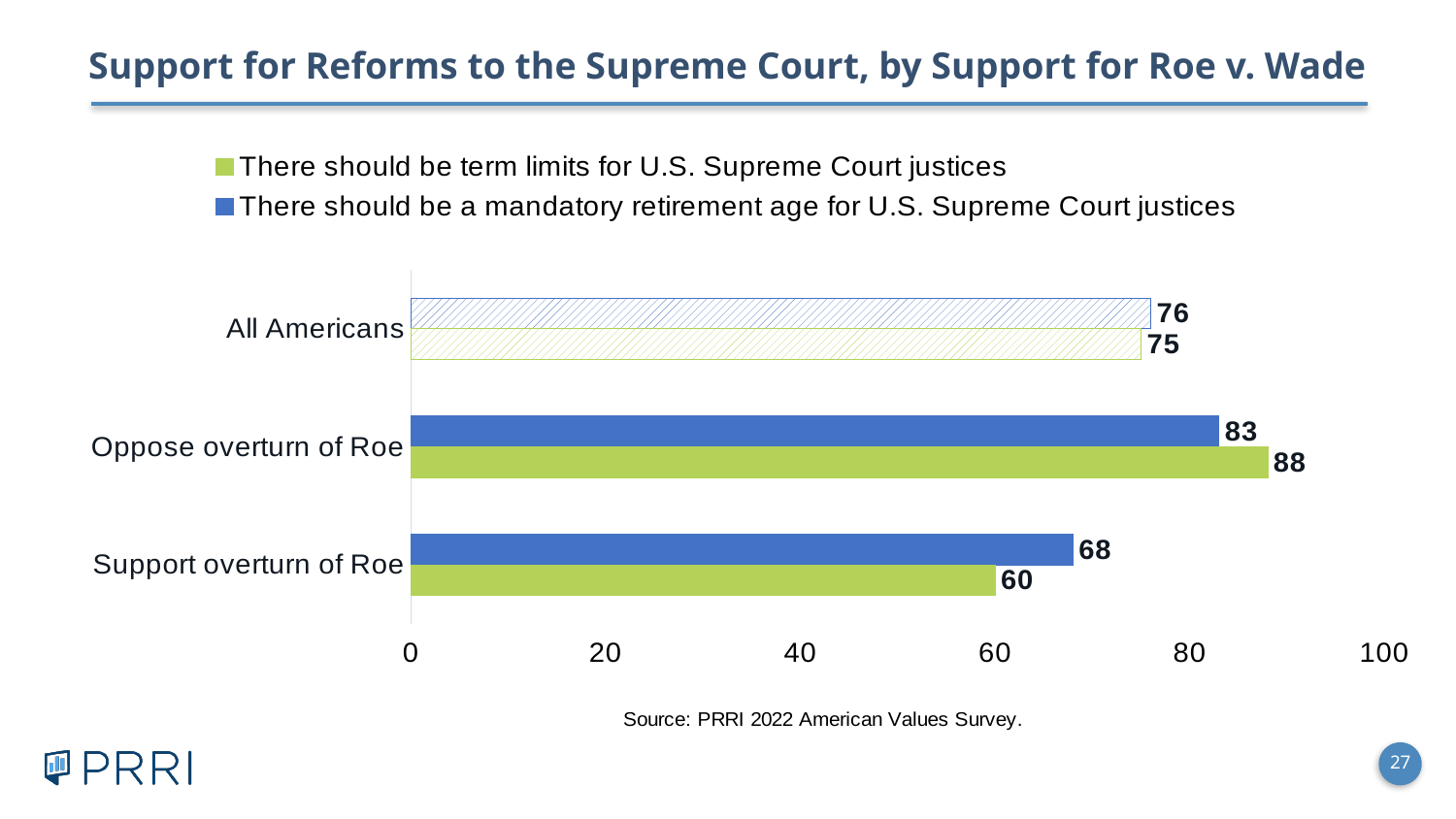
What is the source cited below the chart? PRRI 2022 American Values Survey What is the value for 'Support overturn of Roe' on the term limits series? 60 Is the value for 'Oppose overturn of Roe' on the term limits series greater or less than 80? greater Which category has the lowest value for a mandatory retirement age for U.S. Supreme Court justices? Support overturn of Roe What is the value for 'Oppose overturn of Roe' on the mandatory retirement age series? 83 What kind of chart is shown on the slide? Bar chart For 'Support overturn of Roe', which is larger: support for term limits or support for a mandatory retirement age? Mandatory retirement age How many categories are shown on the chart? 3 What percentage of All Americans say there should be term limits for U.S. Supreme Court justices? 75 How many series does the legend list? 2 What is the difference between the term limits values for 'Oppose overturn of Roe' and 'Support overturn of Roe'? 28 Which category has the highest value for term limits for U.S. Supreme Court justices? Oppose overturn of Roe